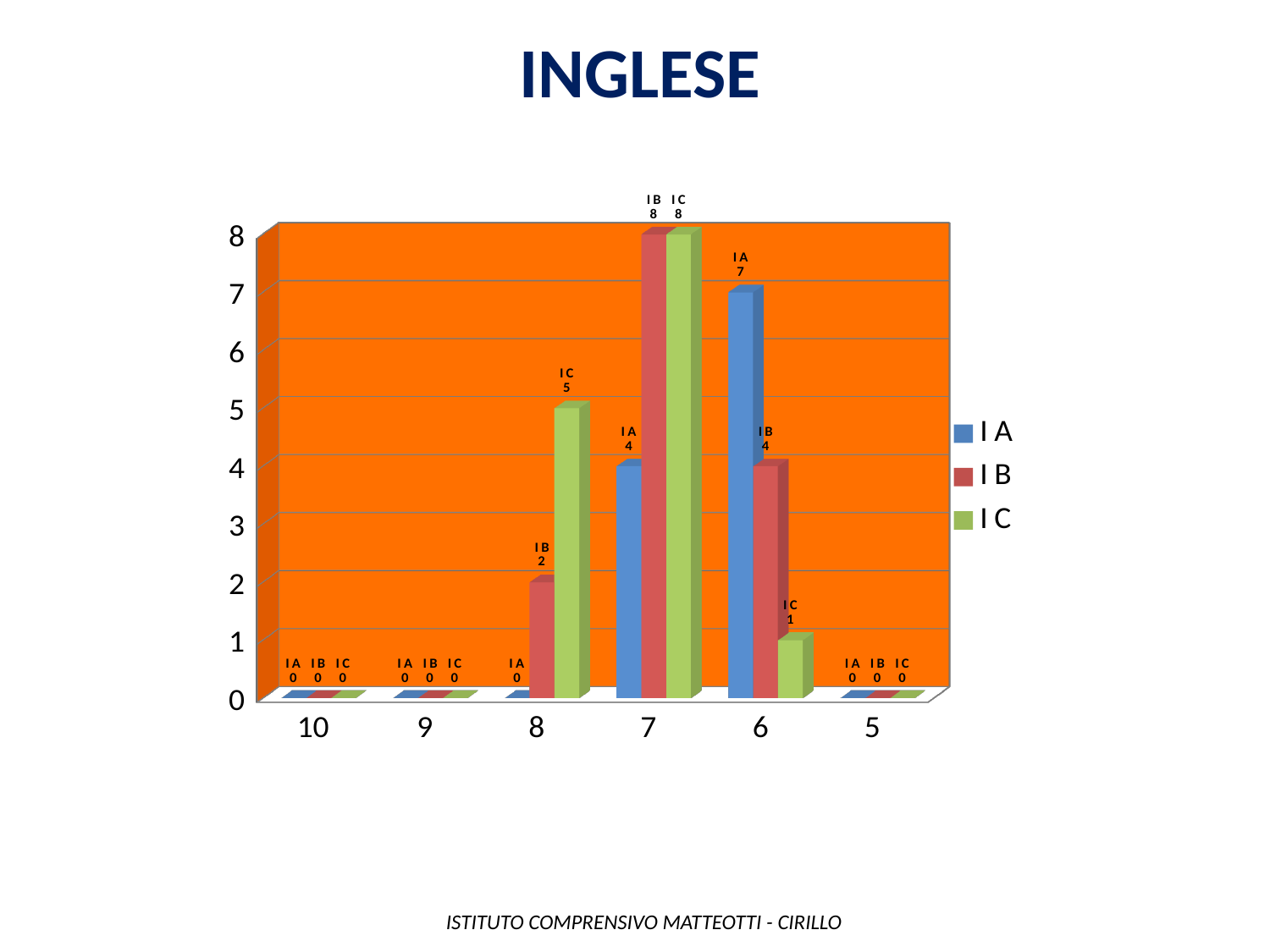
What kind of chart is shown? bar chart What is the value for I A at category 6? 7 What is the total of I A, I B and I C at category 6? 12 What is the title of the chart? INGLESE What is the value for I C at category 6? 1 Which is larger at category 8: I B or I C? I C How many series does the legend list? 3 What is the value for I C at category 8? 5 Which category has the highest value for I A? 6 How many categories are shown on the x axis? 6 What is the value for I B at category 7? 8 What is the difference between I B and I A at category 7? 4